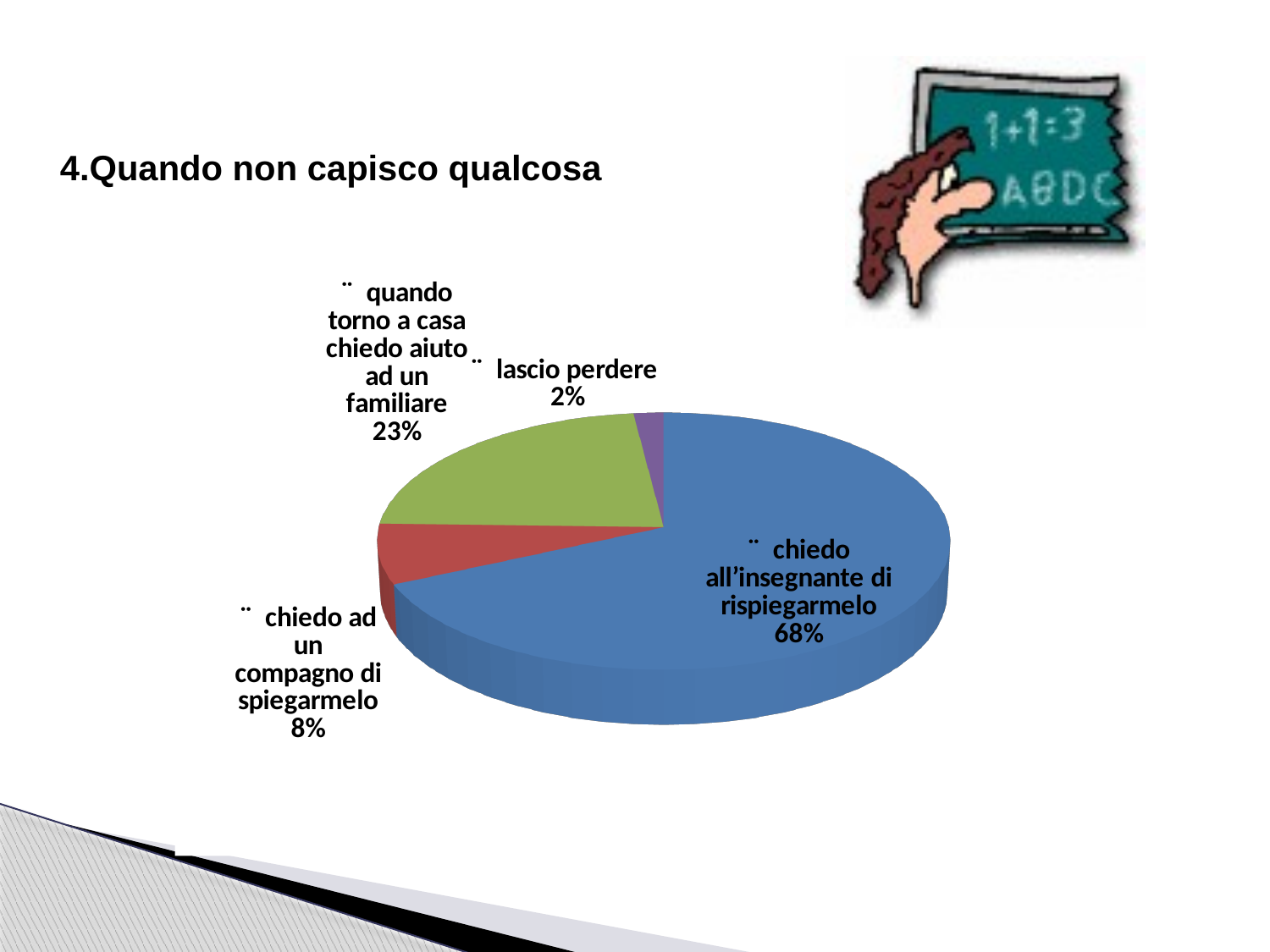
How many slices does the pie chart have? 4 What is the difference in percentage points between 'chiedo all'insegnante di rispiegarmelo' and 'quando torno a casa chiedo aiuto ad un familiare'? 45 Which slice of the pie is the largest? chiedo all'insegnante di rispiegarmelo What percentage of the pie is 'chiedo ad un compagno di spiegarmelo'? 8% What percentage of the pie is 'chiedo all'insegnante di rispiegarmelo'? 68% What colour is the slice for 'chiedo all'insegnante di rispiegarmelo'? blue Which slice of the pie is the smallest? lascio perdere What kind of chart is shown on the slide? pie chart What percentage of the pie is 'quando torno a casa chiedo aiuto ad un familiare'? 23% Which is larger: 'chiedo ad un compagno di spiegarmelo' or 'lascio perdere'? chiedo ad un compagno di spiegarmelo What is the title of the slide containing the pie chart? 4.Quando non capisco qualcosa What percentage of the pie is 'lascio perdere'? 2%